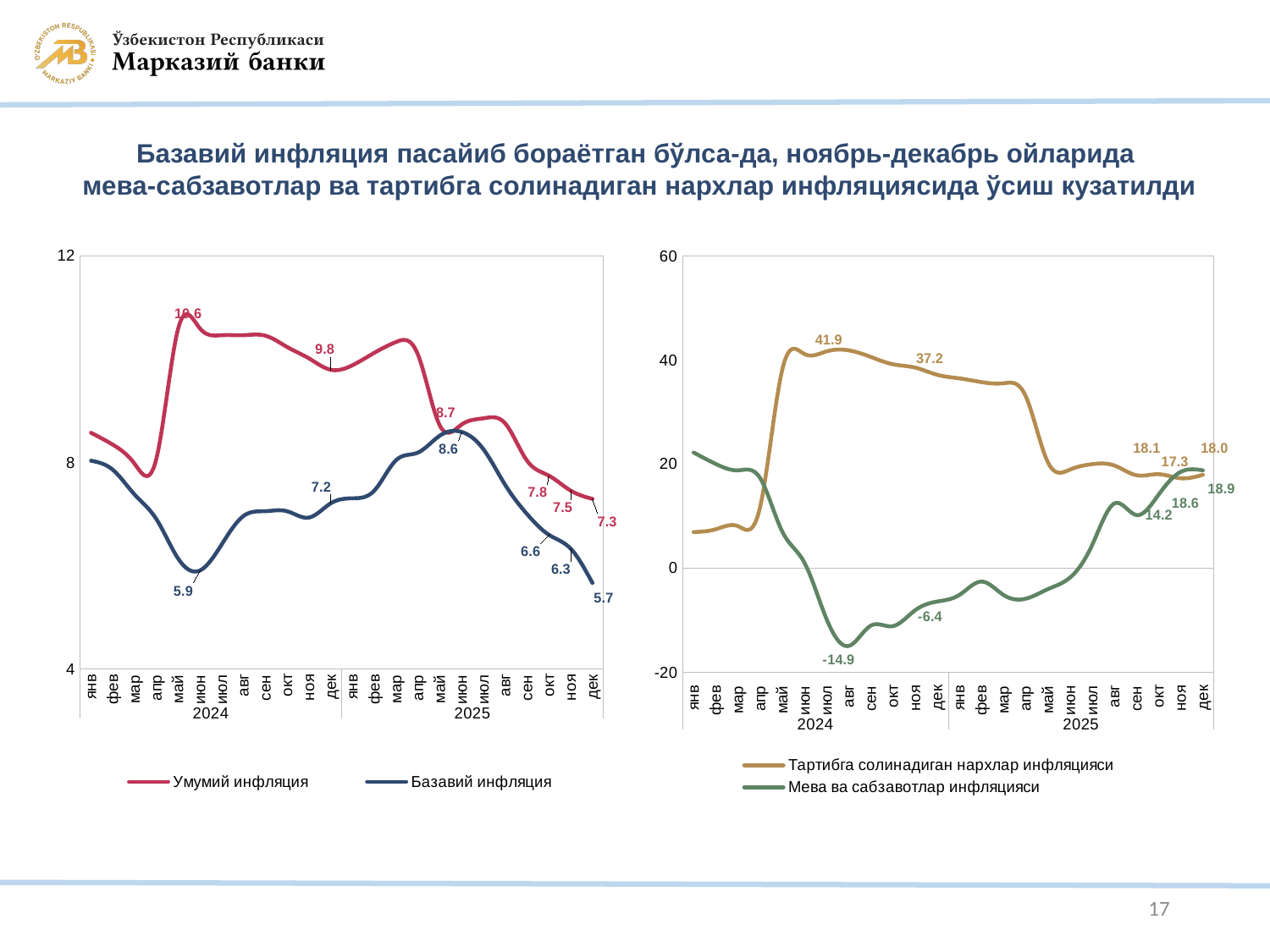
What kind of chart is the left chart? Line chart On the left chart, how many series does the legend list? 2 On the left chart, what is the lowest labelled value of Базавий инфляция? 5.7 On the right chart, is the value of Тартибга солинадиган нархлар инфляцияси at авг 2024 greater or less than 20? greater On the right chart, what is the highest labelled value of Тартибга солинадиган нархлар инфляцияси? 41.9 On the left chart, what is the value of Базавий инфляция at дек 2025? 5.7 On the left chart, what is the value of Умумий инфляция at дек 2025? 7.3 On the left chart, what is the difference between Умумий инфляция and Базавий инфляция at дек 2025? 1.6 On the right chart, what is the value of Тартибга солинадиган нархлар инфляцияси at дек 2025? 18.0 On the left chart, what is the highest labelled value of Умумий инфляция? 10.6 On the right chart, what is the lowest labelled value of Мева ва сабзавотлар инфляцияси? -14.9 On the right chart, what is the value of Мева ва сабзавотлар инфляцияси at дек 2025? 18.9